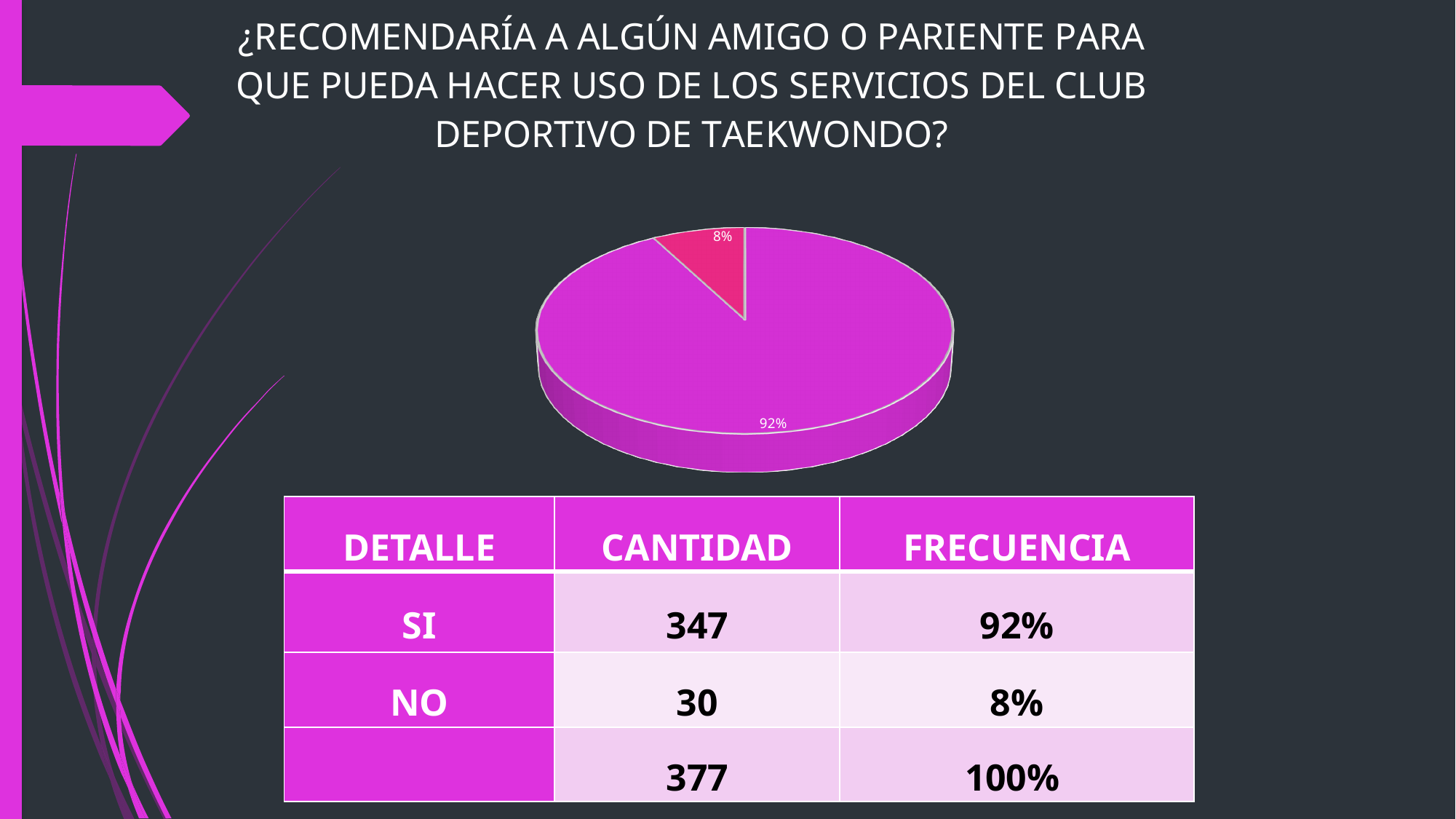
What is the difference in percentage points between the two slices of the pie chart? 84 What percentage is shown on the largest slice of the pie chart? 92% What percentage is shown on the smallest slice of the pie chart? 8% What kind of chart is shown on the slide? pie chart What colour is the smaller slice of the pie chart? pink According to the table below the pie chart, which response corresponds to the 92% slice? SI Which slice of the pie chart is larger, the 92% slice or the 8% slice? the 92% slice According to the table below the pie chart, which response corresponds to the 8% slice? NO What is the total CANTIDAD shown in the table below the pie chart? 377 Is the share of the smaller slice of the pie chart greater or less than 10%? less How many slices does the pie chart have? 2 What is the CANTIDAD value for SI in the table below the pie chart? 347